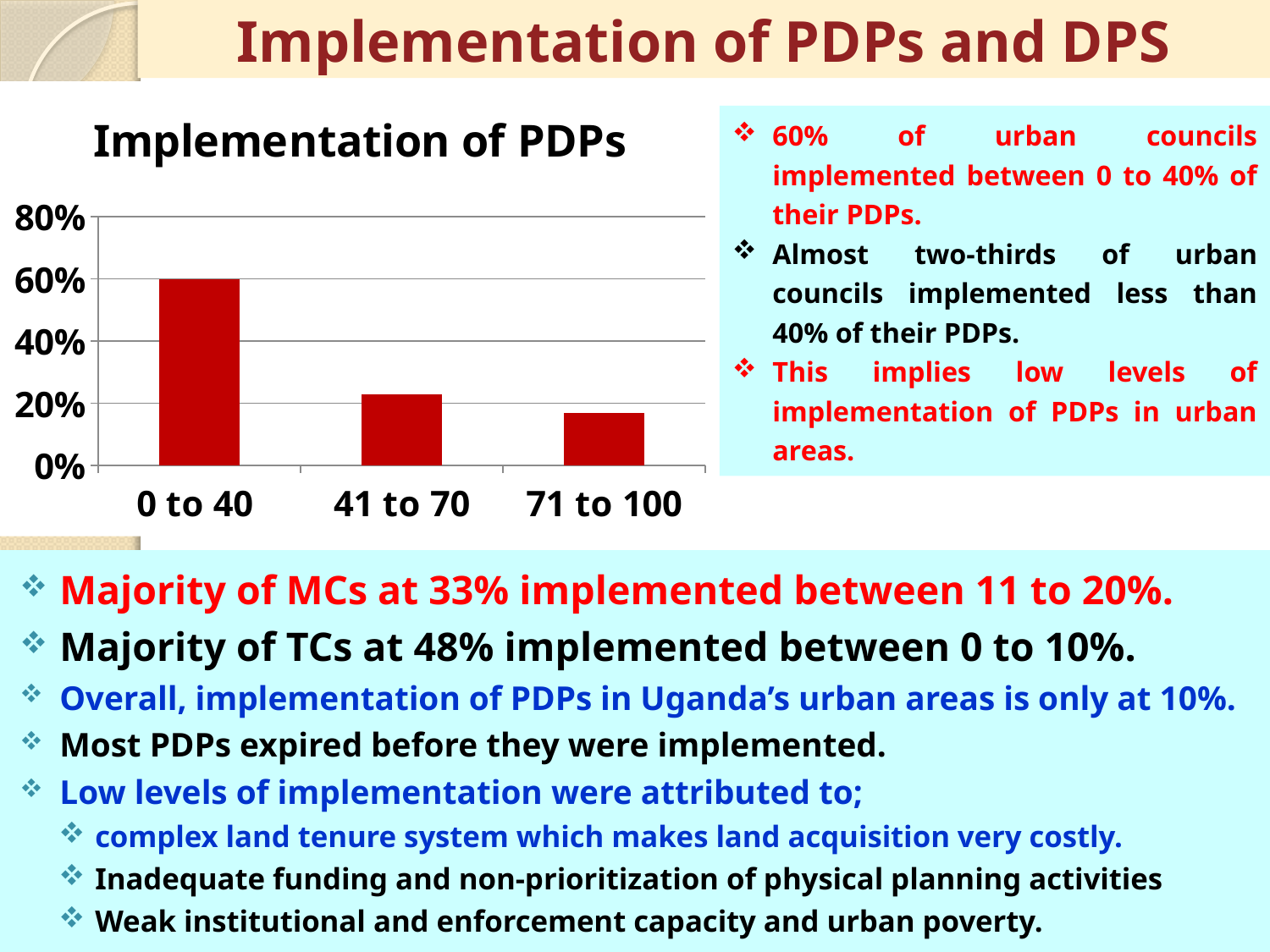
Is the value for 71 to 100 greater or less than 20%? less Which is larger, the value for 41 to 70 or the value for 71 to 100? 41 to 70 How many categories are shown on the x axis of the chart? 3 What colour are the bars in the chart? red What is the value for the 0 to 40 category? 60% What is the title of the chart? Implementation of PDPs Do the values rise or fall from left to right along the x axis? fall Which category has the lowest value? 71 to 100 Is the value for 41 to 70 greater or less than 20%? greater What kind of chart is shown on the slide? bar chart Is the value for 41 to 70 greater or less than 40%? less Which category has the highest value? 0 to 40